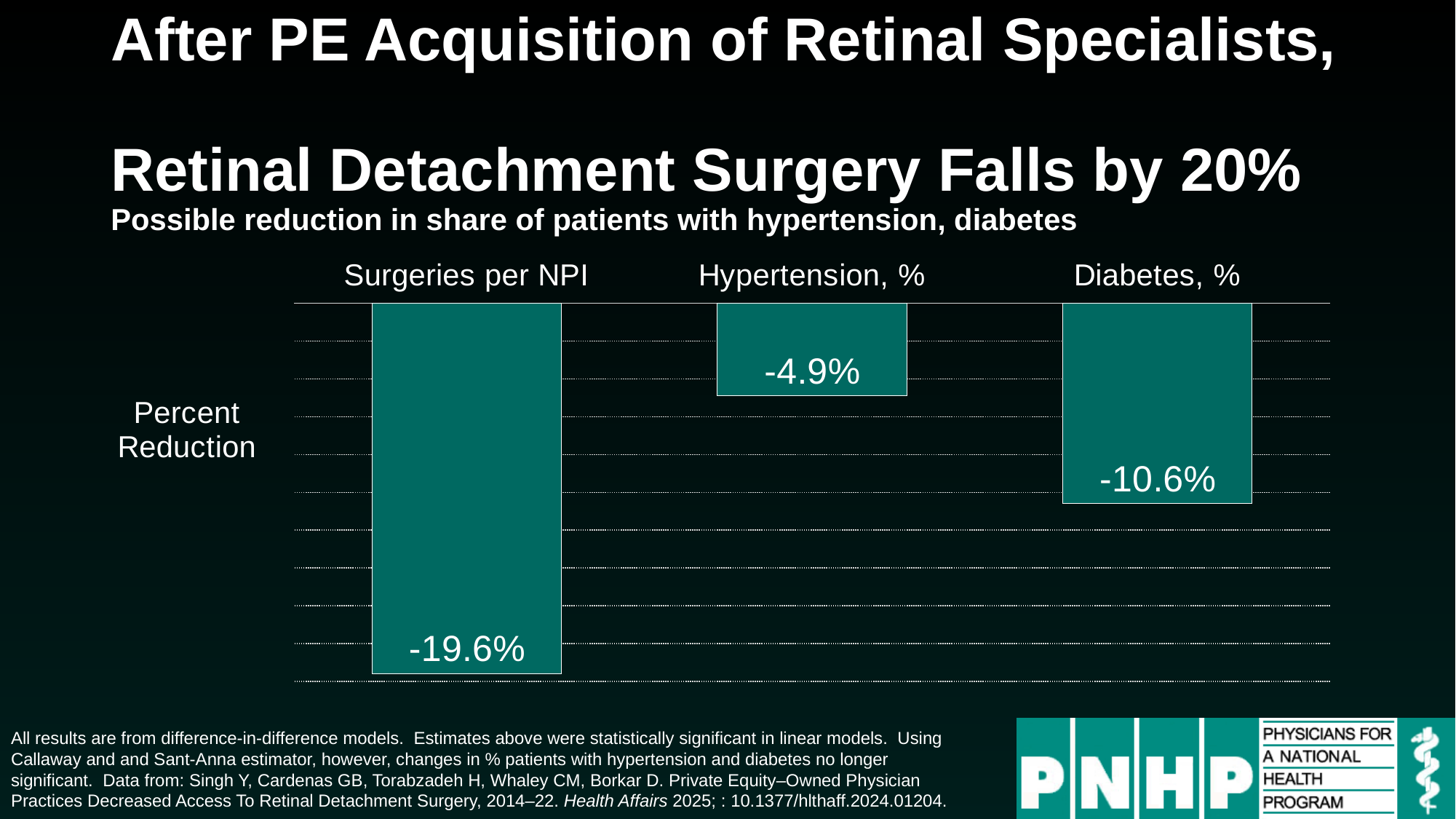
How many categories are plotted in the chart? 3 What kind of chart is shown on the slide? Bar chart By how many percentage points does the reduction for Surgeries per NPI exceed the reduction for Diabetes, %? 9.0 percentage points Which category shows the smallest percent reduction? Hypertension, % Which category shows the largest percent reduction? Surgeries per NPI Which has a larger percent reduction, Diabetes, % or Hypertension, %? Diabetes, % What colour are the bars in the chart? Teal What is the value shown for Hypertension, %? -4.9% By how many percentage points does the reduction for Diabetes, % exceed the reduction for Hypertension, %? 5.7 percentage points What is the label on the vertical axis of the chart? Percent Reduction What is the value shown for Diabetes, %? -10.6% What is the value shown for Surgeries per NPI? -19.6%